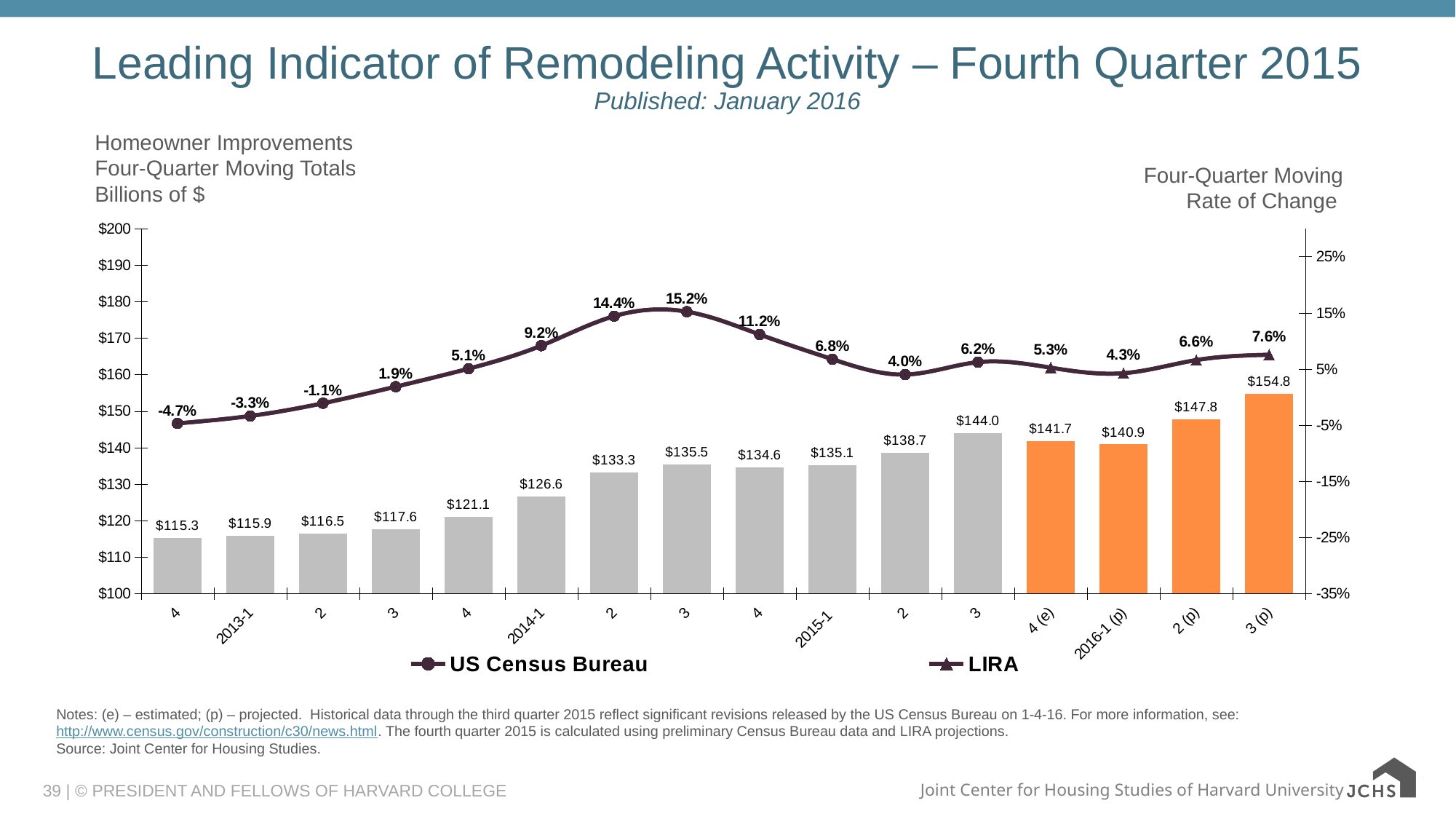
What is the difference between the four-quarter moving totals for 3 (p) and 2 (p) of 2016? $7.0 Do the four-quarter moving totals generally rise or fall from 2012 quarter 4 to 2016 quarter 3 (p)? Rise How many series does the legend list? 2 What is the four-quarter moving rate of change shown for the third quarter of 2014? 15.2% What is the four-quarter moving total for 2015-1? $135.1 What kind of chart is this? Combination bar and line chart What are the two series named in the legend? US Census Bureau and LIRA Which quarter has the lowest four-quarter moving total? 4 (2012), $115.3 Which quarter has the highest four-quarter moving total? 3 (p) (2016), $154.8 Which is larger, the four-quarter moving total for 2015 quarter 3 or for 2015 quarter 4 (e)? 2015 quarter 3 ($144.0) How many bars (quarters) are plotted in the chart? 16 What is the lowest four-quarter moving rate of change shown on the line? -4.7%